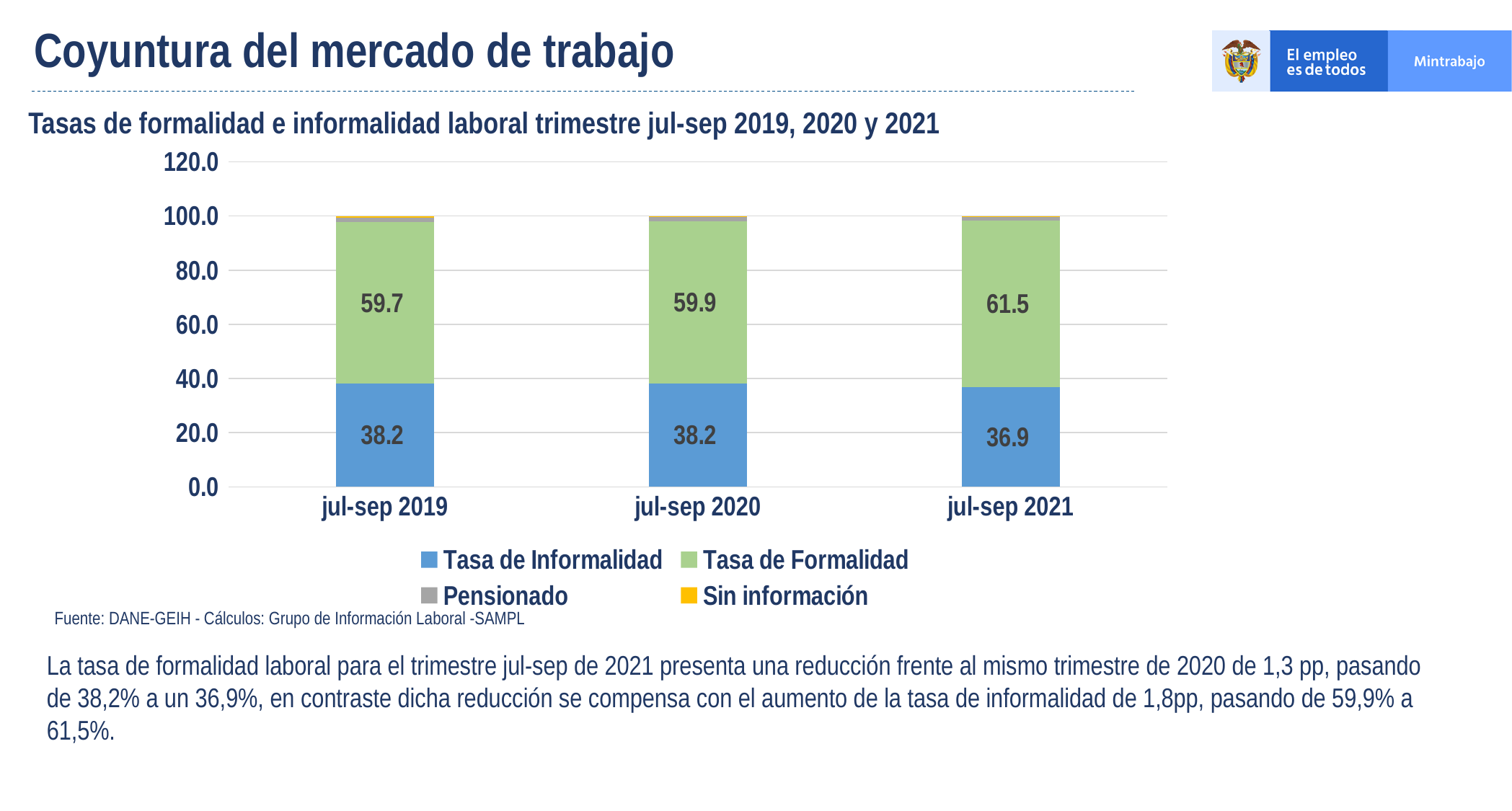
What is the value of Tasa de Informalidad for jul-sep 2019? 38.2 How many periods are shown on the x axis? 3 Is the Tasa de Formalidad value for jul-sep 2019 larger than the Tasa de Informalidad value for jul-sep 2019? Yes Which period has the highest Tasa de Formalidad value? jul-sep 2021 What is the value of Tasa de Formalidad for jul-sep 2020? 59.9 What is the value of Tasa de Formalidad for jul-sep 2021? 61.5 How many series does the legend list? 4 What is the value of Tasa de Informalidad for jul-sep 2021? 36.9 What kind of chart is shown on the slide? Stacked bar chart What is the difference between the Tasa de Formalidad values for jul-sep 2021 and jul-sep 2020? 1.6 What is the difference between the Tasa de Informalidad values for jul-sep 2020 and jul-sep 2021? 1.3 Which period has the lowest Tasa de Informalidad value? jul-sep 2021